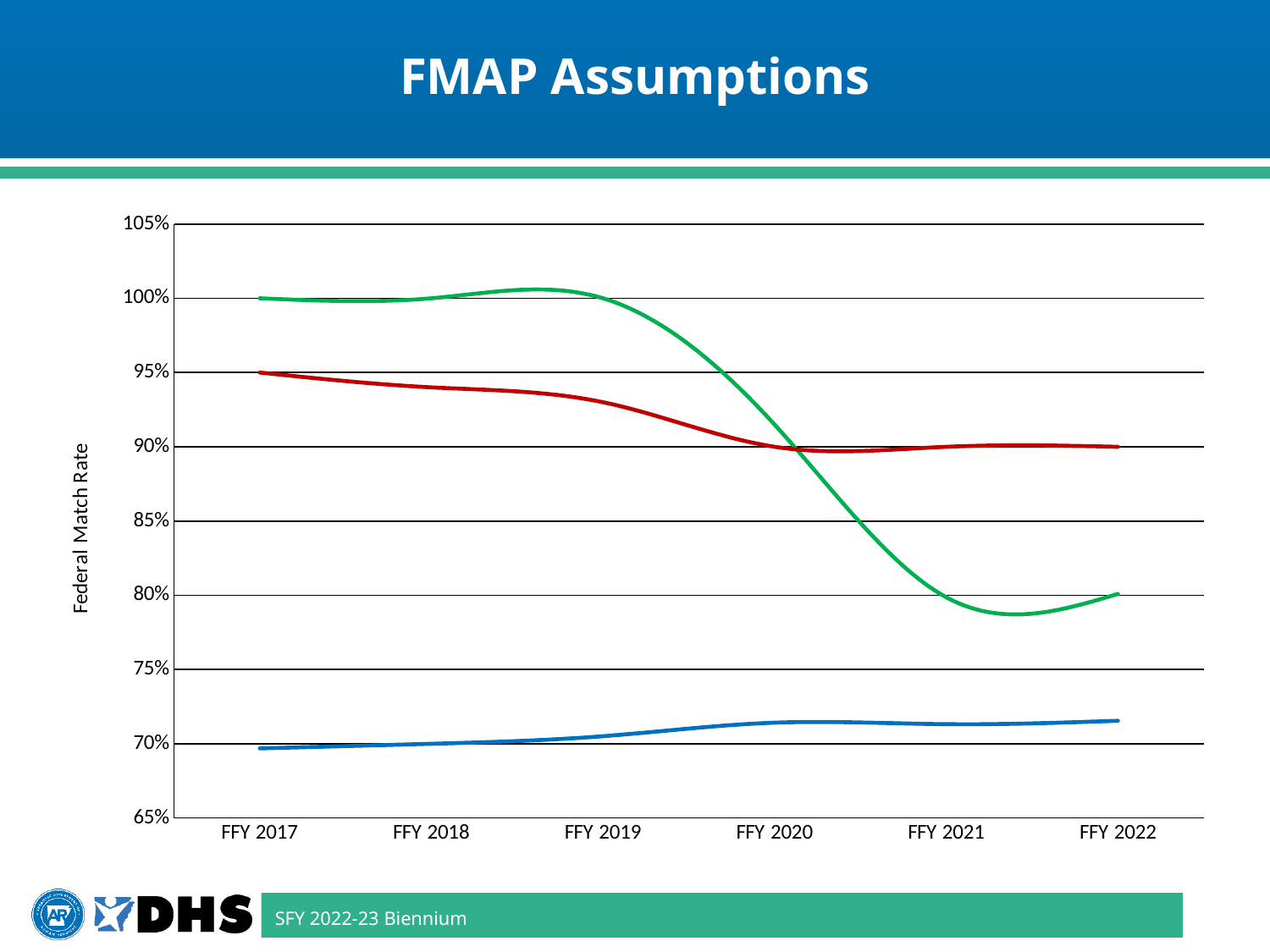
How many fiscal years are shown on the x axis of the chart? 6 What is the value of the red line at FFY 2017? 95% Which line has the lowest value at FFY 2022? Blue line Is the value of the blue line at FFY 2022 greater or less than 75%? less At FFY 2022, which line has the larger value, the red line or the green line? Red line How many lines are plotted on the chart? 3 What is the value of the green line at FFY 2017? 100% What type of chart is shown on the slide? Line chart Does the green line rise or fall from FFY 2017 to FFY 2022? Fall What is the value of the red line at FFY 2022? 90% What is the label of the vertical axis? Federal Match Rate